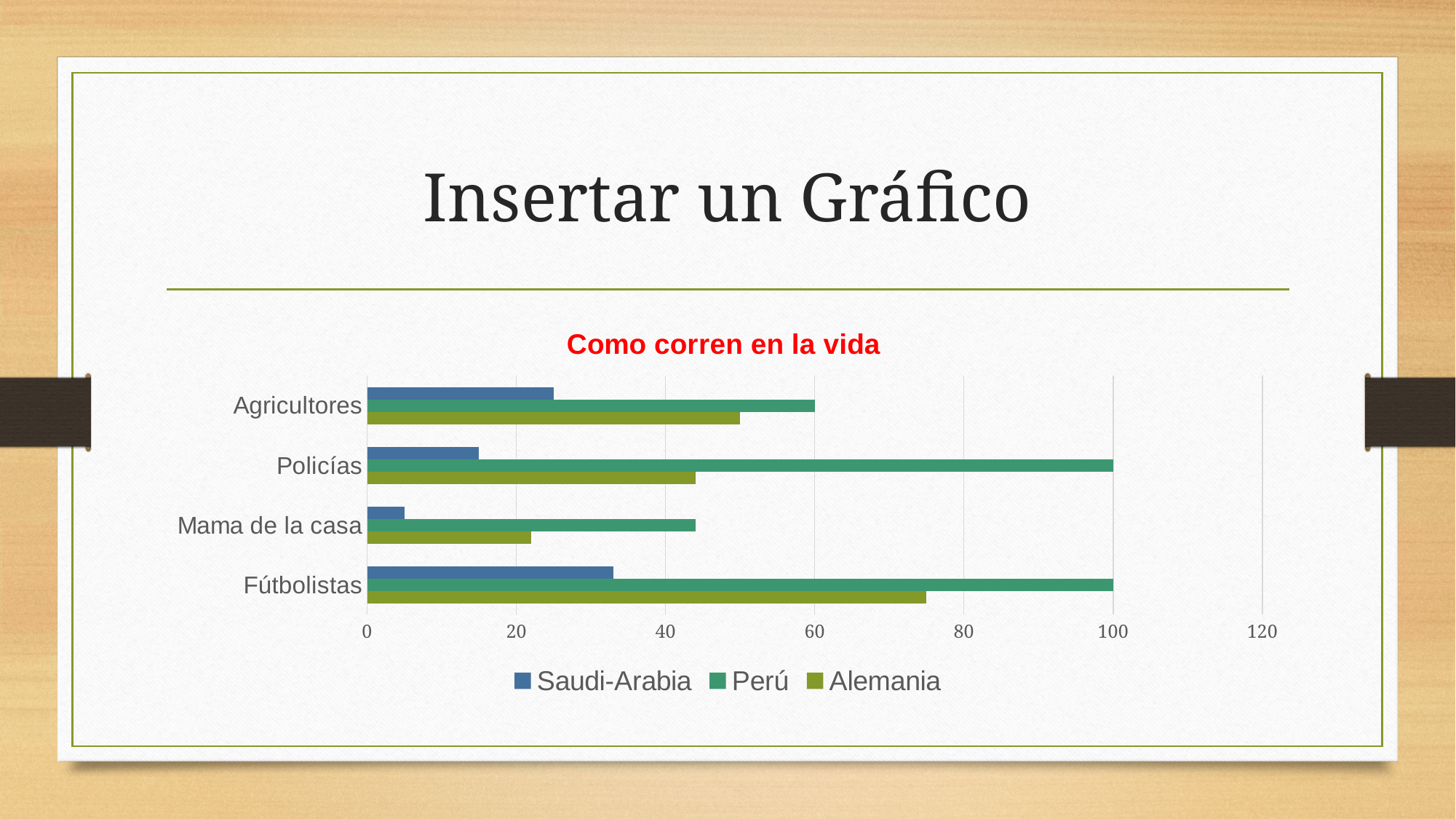
Is the value for Saudi-Arabia in the Mama de la casa category greater or less than 20? less In the Policías category, which is larger: Perú or Alemania? Perú What is the value for Perú in the Policías category? 100 What type of chart is shown on the slide? bar chart Which series has the highest value in the Agricultores category? Perú How many categories are shown on the chart? 4 What is the value for Perú in the Fútbolistas category? 100 What is the title of the chart? Como corren en la vida Is the value for Alemania in the Fútbolistas category greater or less than 60? greater What is the value for Perú in the Agricultores category? 60 For the Saudi-Arabia series, which category has the lowest value? Mama de la casa How many series does the legend list? 3